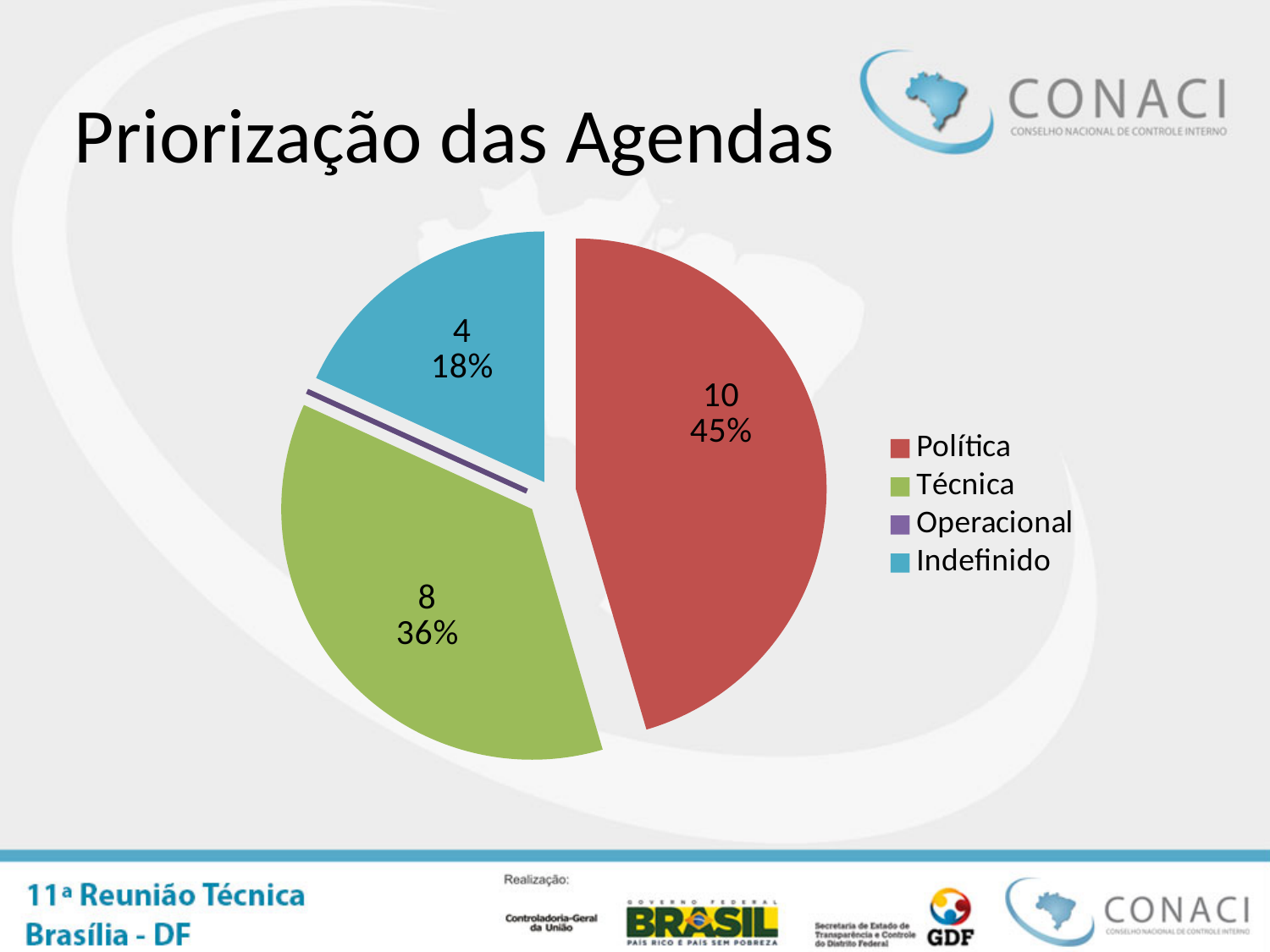
What is the difference between the values for Política and Técnica? 2 Which category has the largest slice of the pie? Política What kind of chart is shown on the slide? pie chart What is the title of the chart? Priorização das Agendas What share of the pie does Política represent? 45% What is the value shown for Técnica? 8 What is the value shown for Indefinido? 4 How many categories does the legend list? 4 Which category has the smallest slice of the pie? Operacional What share of the pie does Técnica represent? 36% What share of the pie does Indefinido represent? 18% What is the value shown for Política? 10